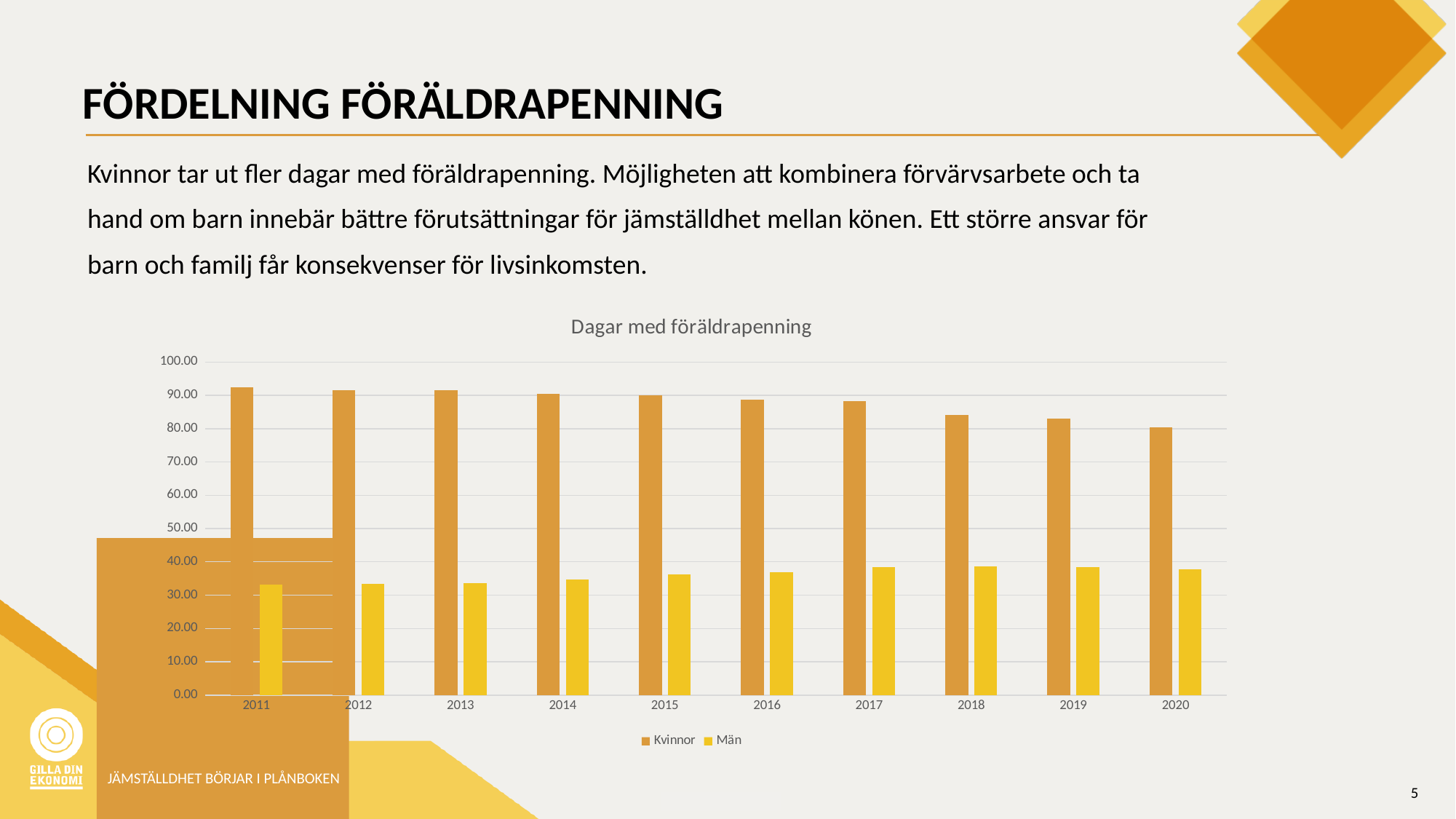
Which year has the highest value for Kvinnor? 2011 What kind of chart is shown on the slide? bar chart Which year has the lowest value for Kvinnor? 2020 Is the value for Kvinnor in 2020 greater or less than 70? greater What is the title of the chart? Dagar med föräldrapenning How many years are shown on the x axis of the chart? 10 In 2015, which is larger, the value for Kvinnor or the value for Män? Kvinnor Do the values for Kvinnor rise or fall from 2011 to 2020? fall Is the value for Kvinnor in 2011 greater or less than 90? greater Is the value for Män in 2011 greater or less than 40? less Do the values for Män rise or fall from 2011 to 2019? rise How many series does the chart legend list? 2